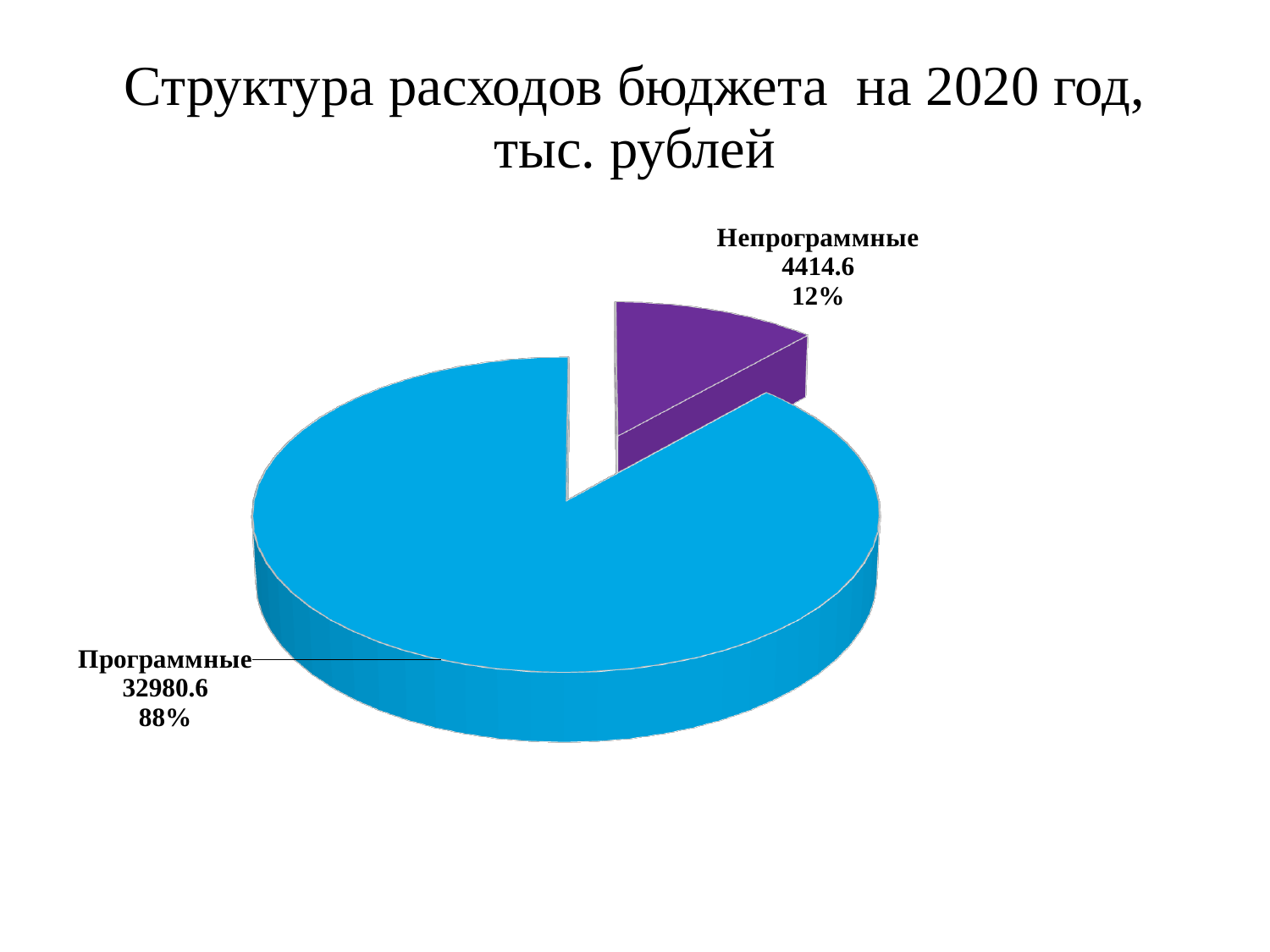
Which category has the smallest slice? Непрограммные Which category has the largest slice? Программные How many categories are shown in the chart? 2 What is the value for Непрограммные? 4414.6 What colour is the Непрограммные slice? Purple What share of the pie does Программные take? 88% What is the title of the slide? Структура расходов бюджета на 2020 год, тыс. рублей Which is larger, Программные or Непрограммные? Программные What is the value for Программные? 32980.6 What kind of chart is shown on the slide? Pie chart What share of the pie does Непрограммные take? 12% What is the difference between the values for Программные and Непрограммные? 28566